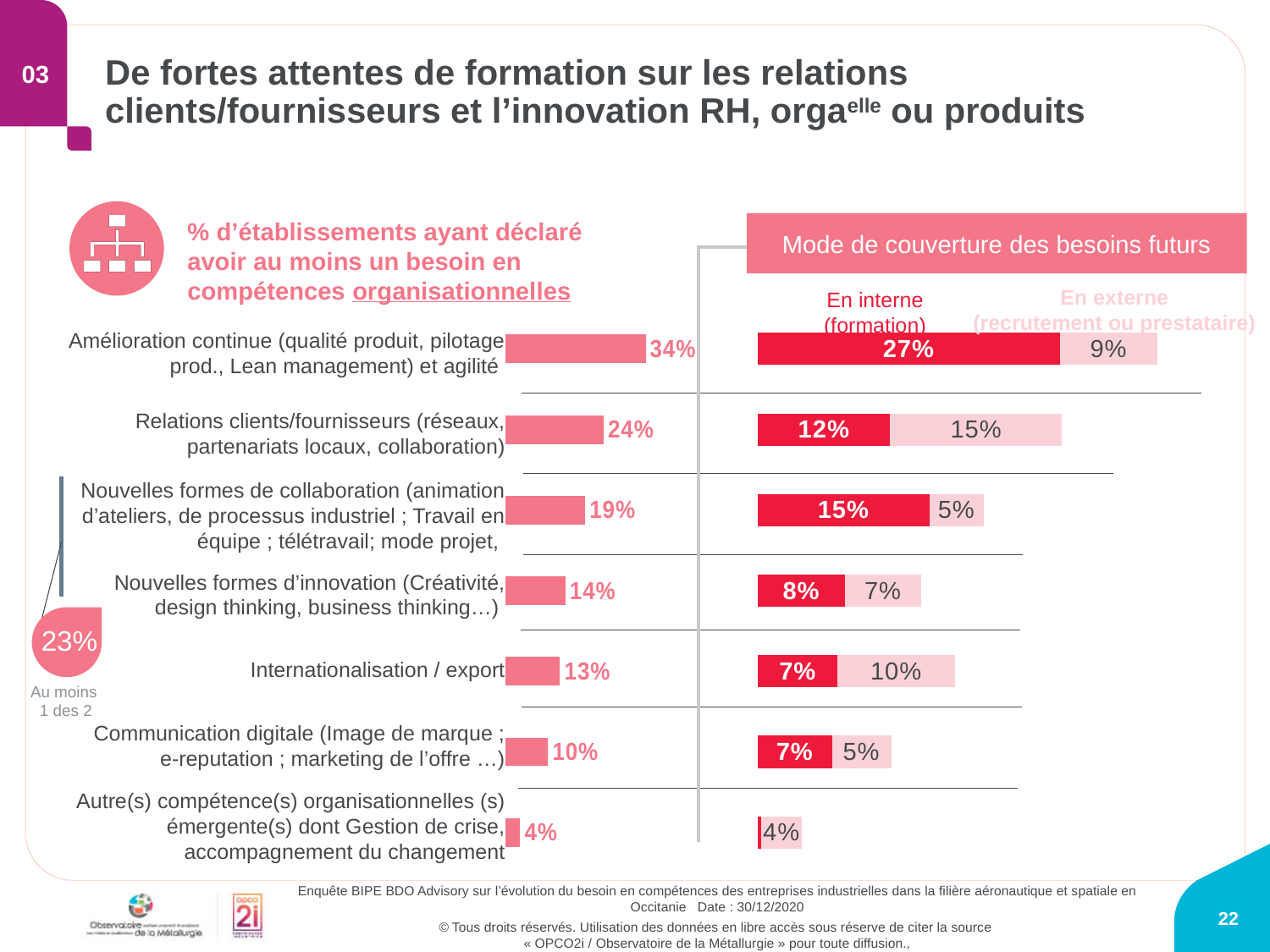
How many series does the right chart 'Mode de couverture des besoins futurs' show? 2 In the right chart 'Mode de couverture des besoins futurs', what is the 'En interne (formation)' value for 'Relations clients/fournisseurs'? 12% In the right chart 'Mode de couverture des besoins futurs', what is the total of the stacked bar for 'Amélioration continue'? 36% In the left chart '% d'établissements ayant déclaré avoir au moins un besoin en compétences organisationnelles', what is the difference between 'Relations clients/fournisseurs' and 'Communication digitale'? 14% In the right chart 'Mode de couverture des besoins futurs', which is larger for 'Nouvelles formes de collaboration': 'En interne (formation)' or 'En externe (recrutement ou prestataire)'? En interne (formation) In the left chart '% d'établissements ayant déclaré avoir au moins un besoin en compétences organisationnelles', what is the value for 'Internationalisation / export'? 13% In the right chart 'Mode de couverture des besoins futurs', what is the 'En externe (recrutement ou prestataire)' value for 'Internationalisation / export'? 10% In the left chart '% d'établissements ayant déclaré avoir au moins un besoin en compétences organisationnelles', which category has the lowest value? Autre(s) compétence(s) organisationnelles (s) émergente(s) dont Gestion de crise, accompagnement du changement In the left chart '% d'établissements ayant déclaré avoir au moins un besoin en compétences organisationnelles', what is the value for 'Amélioration continue (qualité produit, pilotage prod., Lean management) et agilité'? 34% In the left chart '% d'établissements ayant déclaré avoir au moins un besoin en compétences organisationnelles', which category has the highest value? Amélioration continue (qualité produit, pilotage prod., Lean management) et agilité How many categories are shown in the left chart '% d'établissements ayant déclaré avoir au moins un besoin en compétences organisationnelles'? 7 What type of chart is the left chart '% d'établissements ayant déclaré avoir au moins un besoin en compétences organisationnelles'? Bar chart